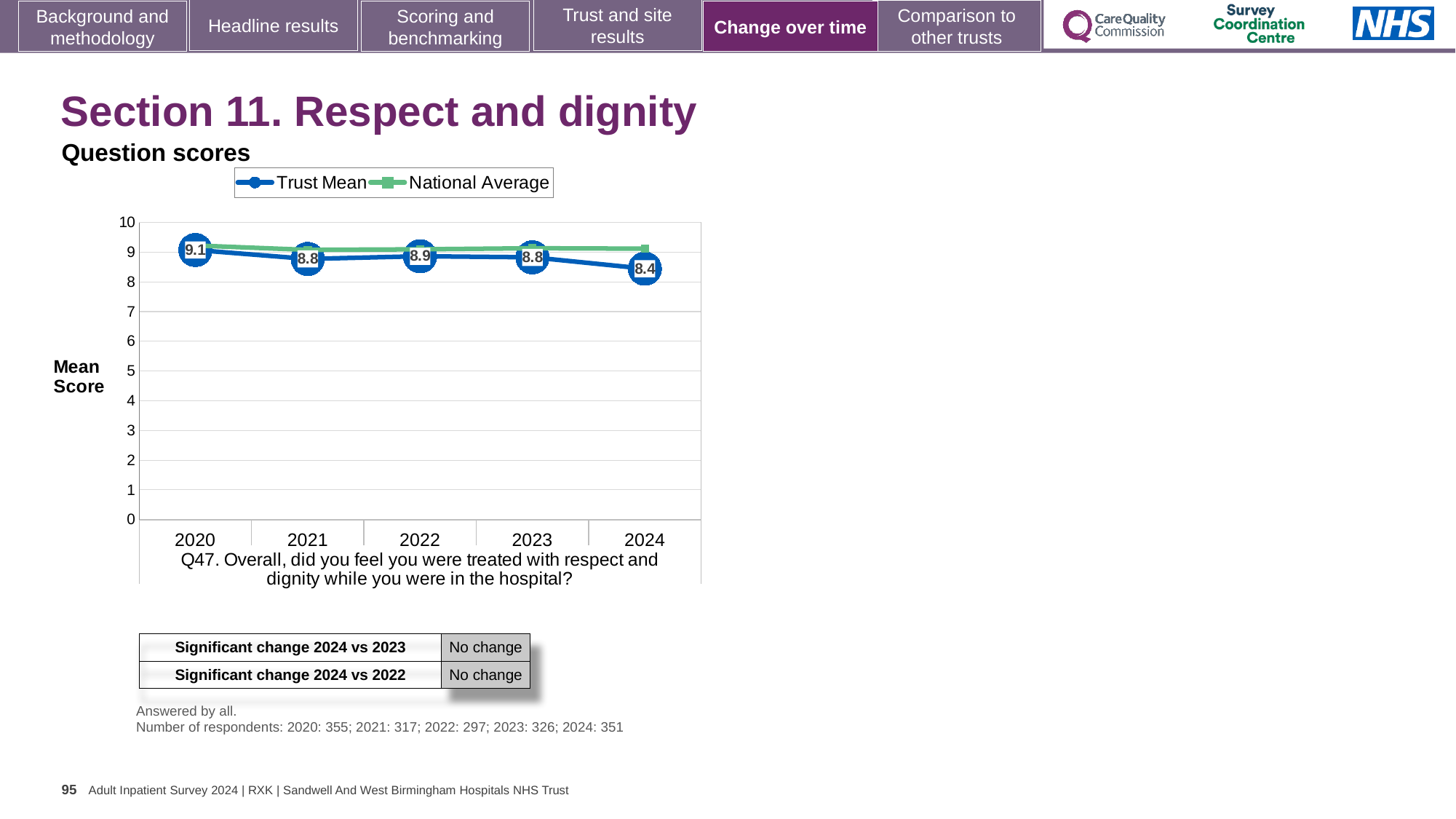
Does the Trust Mean score rise or fall from 2023 to 2024? fall Which year has a higher Trust Mean score, 2022 or 2024? 2022 What is the Trust Mean score for 2020? 9.1 In which year is the Trust Mean score lowest? 2024 In which year is the Trust Mean score highest? 2020 What is the Trust Mean score for 2024? 8.4 What kind of chart is shown on the slide? line chart Is the National Average for 2024 greater or less than 8? greater What is the Trust Mean score for 2022? 8.9 How many series does the chart legend list? 2 How many years are shown on the x axis of the chart? 5 What is the difference between the Trust Mean scores for 2020 and 2024? 0.7